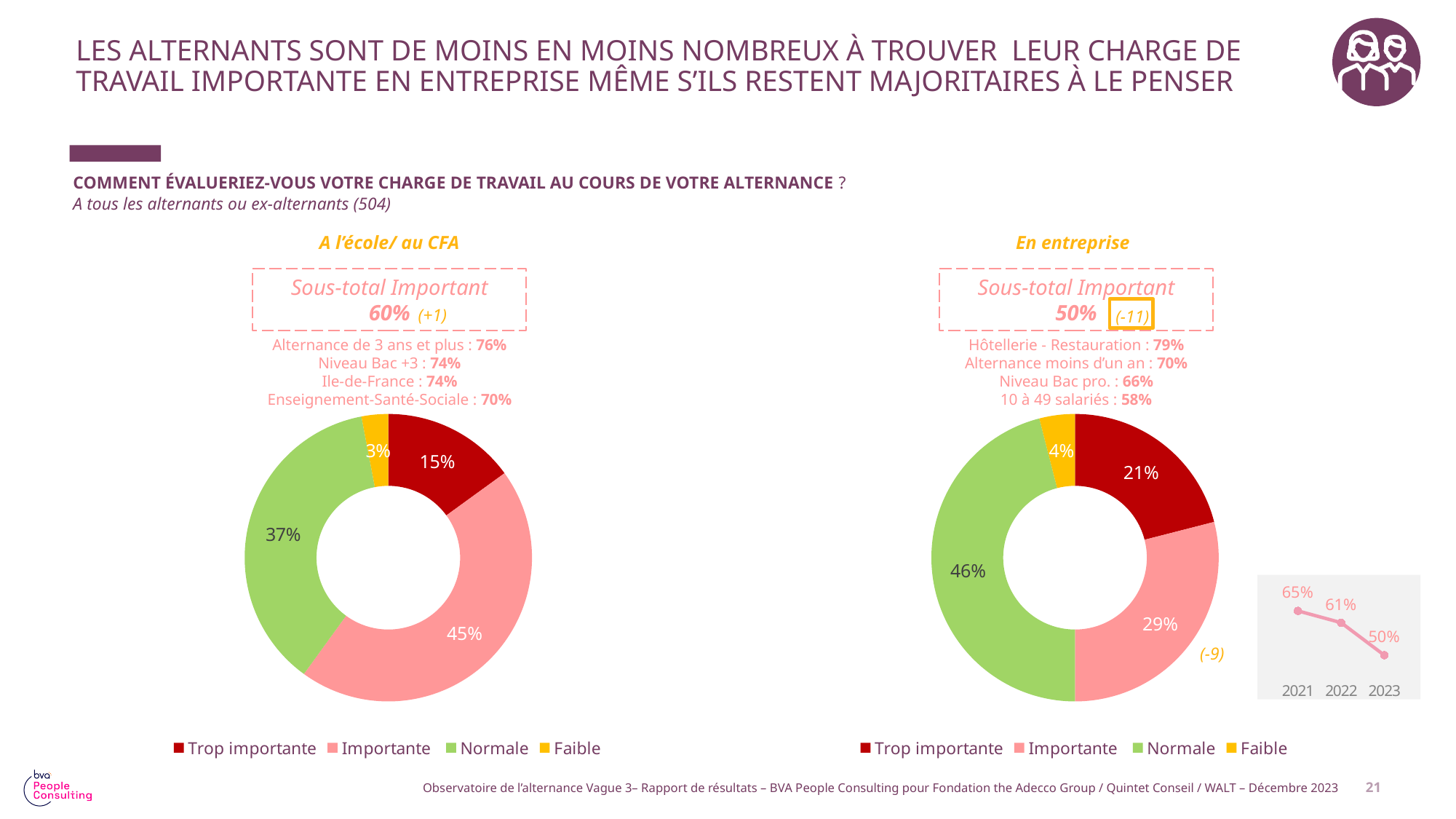
In the 'En entreprise' chart, which category has the largest share? Normale In the small line chart at the bottom right, do the values rise or fall from 2021 to 2023? Fall In the 'En entreprise' chart, what percentage is shown for 'Trop importante'? 21% In the small line chart at the bottom right, what value is shown for 2021? 65% What colour represents 'Faible' in the donut chart legends? Yellow In the 'A l'école/ au CFA' chart, which category has the smallest share? Faible In the 'A l'école/ au CFA' chart, which is larger: 'Importante' or 'Normale'? Importante What type of chart is used for 'A l'école/ au CFA' and 'En entreprise'? Donut (pie) chart What is the difference between the 'Trop importante' share in the 'En entreprise' chart and the 'Trop importante' share in the 'A l'école/ au CFA' chart? 6 points In the 'En entreprise' chart, what percentage is shown for 'Normale'? 46% In the 'A l'école/ au CFA' chart, what percentage is shown for 'Importante'? 45% How many categories does each donut chart show? 4